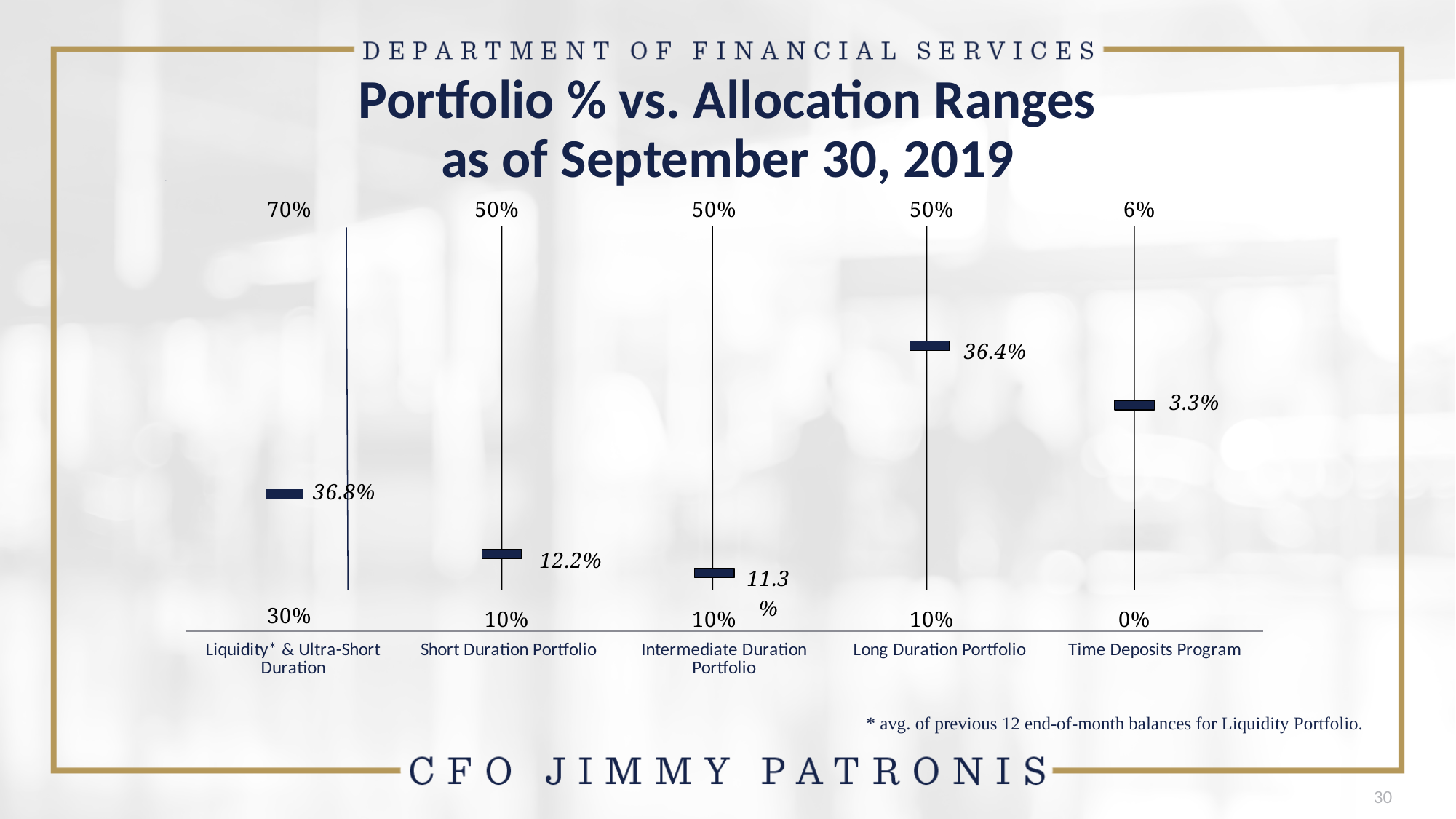
What is the portfolio percentage shown for the Long Duration Portfolio? 36.4% What is the portfolio percentage shown for the Short Duration Portfolio? 12.2% Which category has the lowest portfolio percentage? Time Deposits Program What is the portfolio percentage shown for the Time Deposits Program? 3.3% What is the lower limit of the allocation range for the Time Deposits Program? 0% What is the title of the chart? Portfolio % vs. Allocation Ranges as of September 30, 2019 What is the portfolio percentage shown for the Intermediate Duration Portfolio? 11.3% What is the upper limit of the allocation range for Liquidity* & Ultra-Short Duration? 70% What is the difference between the portfolio percentages of the Short Duration Portfolio and the Intermediate Duration Portfolio? 0.9 percentage points Which category has the highest portfolio percentage? Liquidity* & Ultra-Short Duration How many portfolio categories are shown on the chart? 5 Which is larger, the portfolio percentage for the Long Duration Portfolio or for the Short Duration Portfolio? Long Duration Portfolio